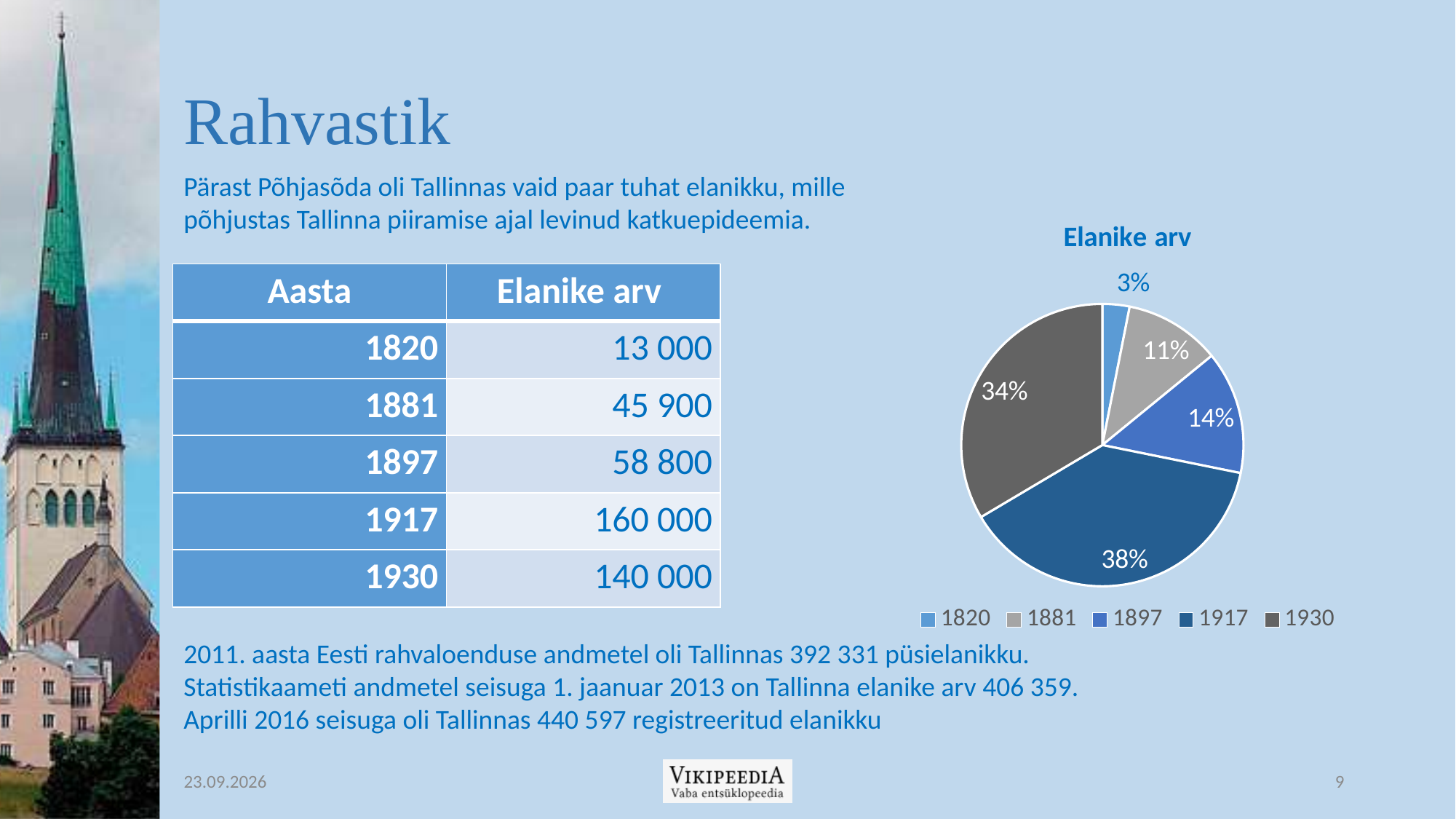
What is the difference in percentage points between the 1917 slice and the 1930 slice? 4% What share of the pie does the 1820 slice represent? 3% What kind of chart is shown on the slide? pie chart Which year has the largest slice of the pie? 1917 What is the title of the chart? Elanike arv Which year has the smallest slice of the pie? 1820 Which slice is larger, 1897 or 1881? 1897 What share of the pie does the 1897 slice represent? 14% What share of the pie does the 1917 slice represent? 38% How many slices does the pie chart have? 5